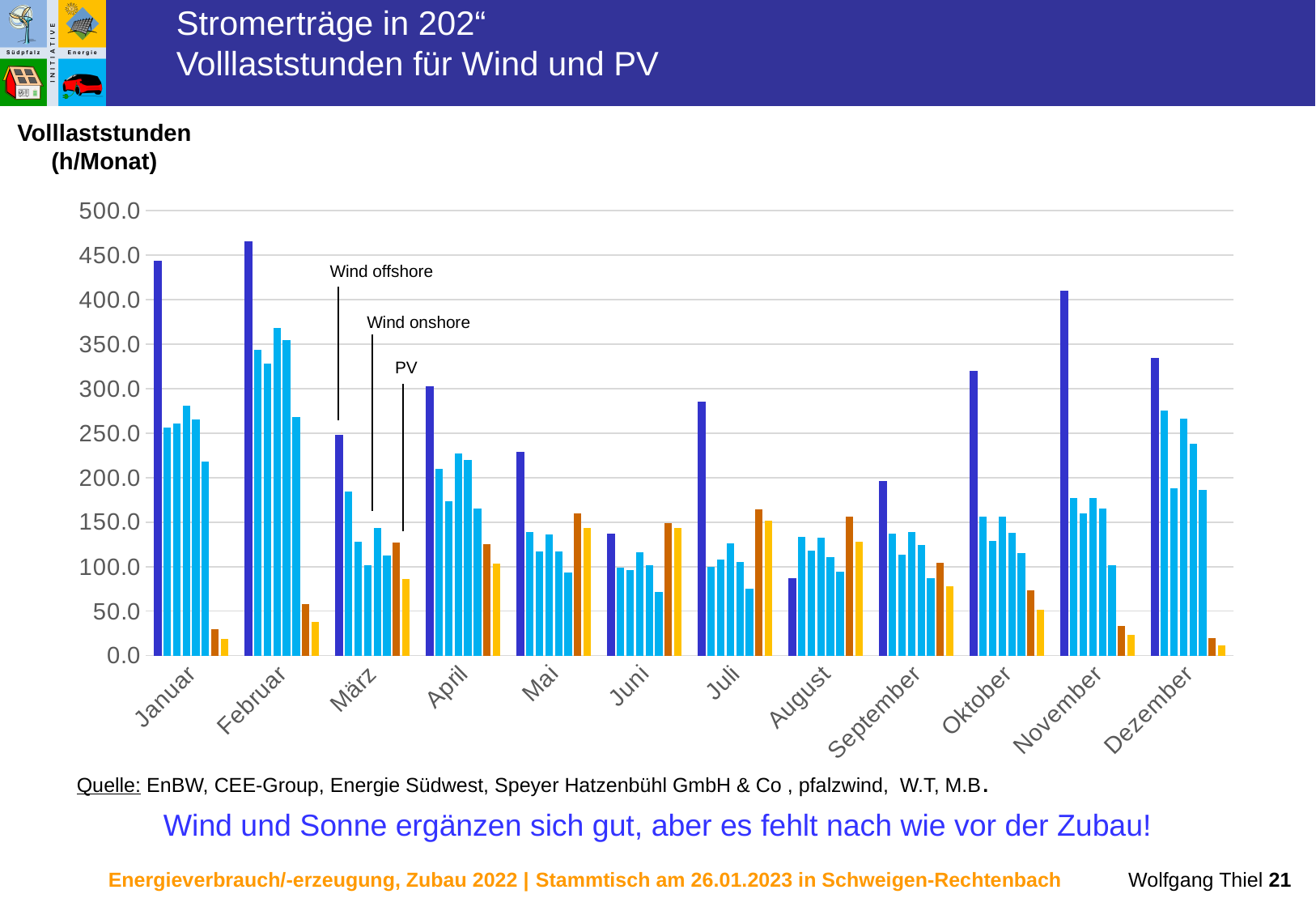
What is the y-axis label of the chart? Volllaststunden (h/Monat) Is the Wind offshore value for Oktober greater or less than 300? greater Is the Wind offshore value for August greater or less than 100? less Which month has the lowest Wind offshore value? August How many months are shown along the x axis of the chart? 12 Is the Wind offshore value for Februar greater or less than 450? greater Which is larger, the Wind offshore value for Mai or for Juni? Mai Which is larger, the Wind offshore value for Januar or for Juli? Januar Which three series are labelled by the annotations in the chart? Wind offshore, Wind onshore, PV What kind of chart is shown on the slide? bar chart